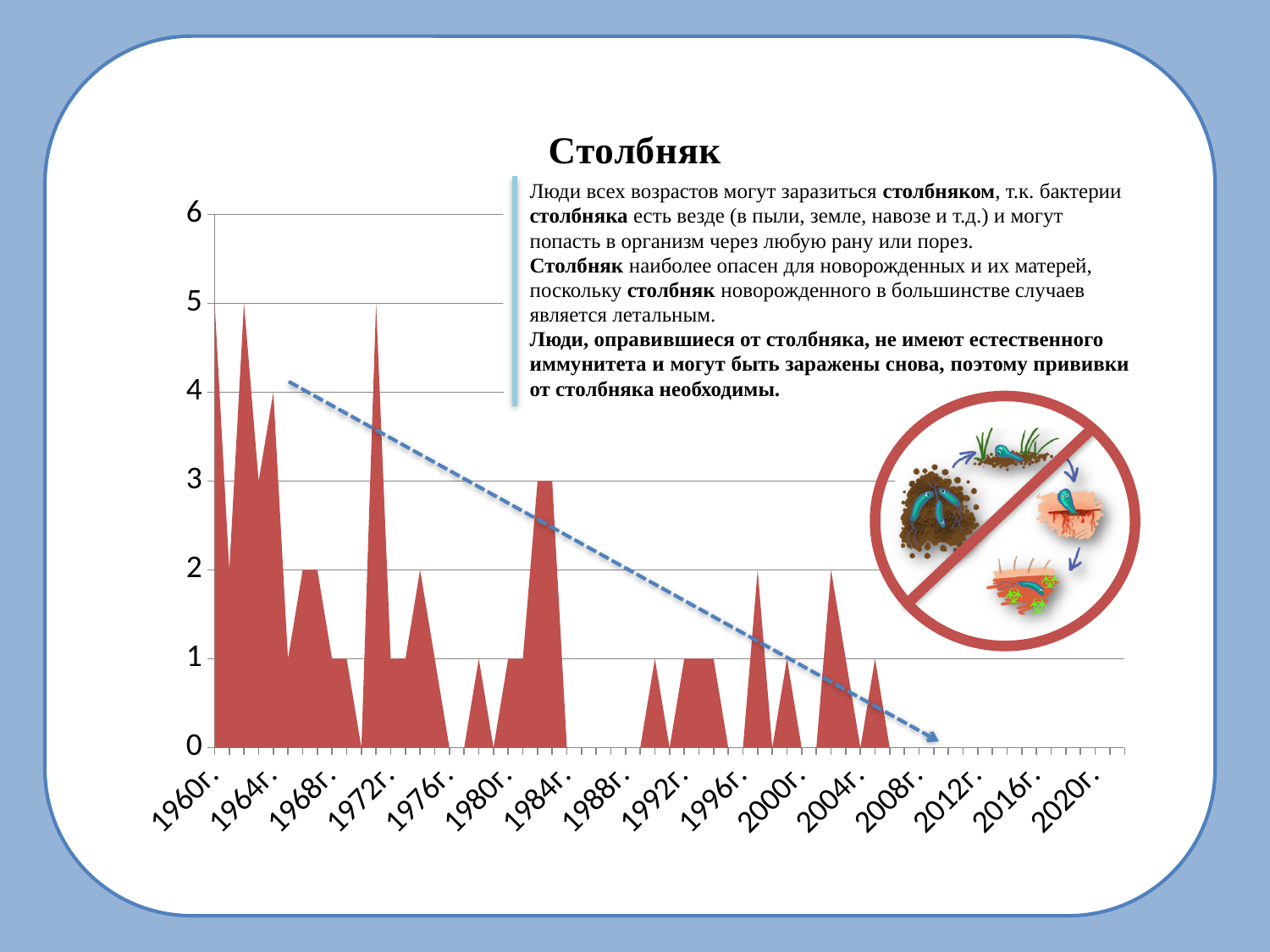
How many year labels are shown on the x axis? 16 What is the value for 1972г.? 1 Is the value for 1968г. greater or less than 2? less What is the value for 2020г.? 0 What is the value for 1984г.? 0 Is the value for 1964г. greater or less than 3? greater What colour is the filled area of the chart? red What is the value for 2016г.? 0 What kind of chart is shown on the slide? area chart Which is larger, the value for 1972г. or the value for 1984г.? 1972г. Do the values generally rise or fall from 1960 to 2020? fall Is the value for 1988г. greater or less than 1? less